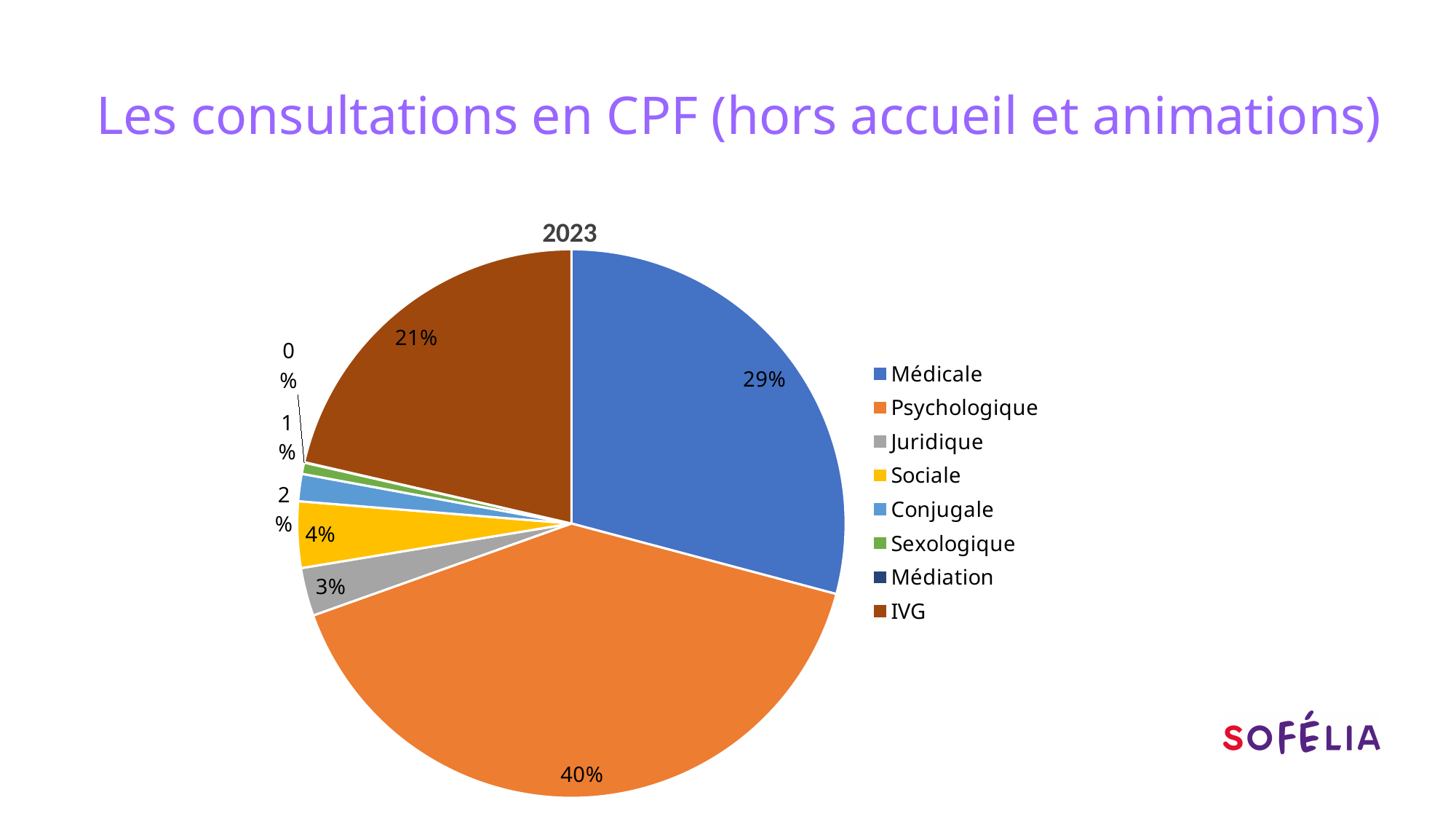
What type of chart is shown on the slide? pie chart Which category has the largest share of the pie? Psychologique What share of the pie is Sociale? 4% How many categories does the legend list? 8 What share of the pie is IVG? 21% Which colour represents IVG in the legend? brown What is the difference in percentage points between the Psychologique share and the Médicale share? 11 What share of the pie is Médicale? 29% Which is larger, the share for Médicale or the share for IVG? Médicale What is the chart's title? 2023